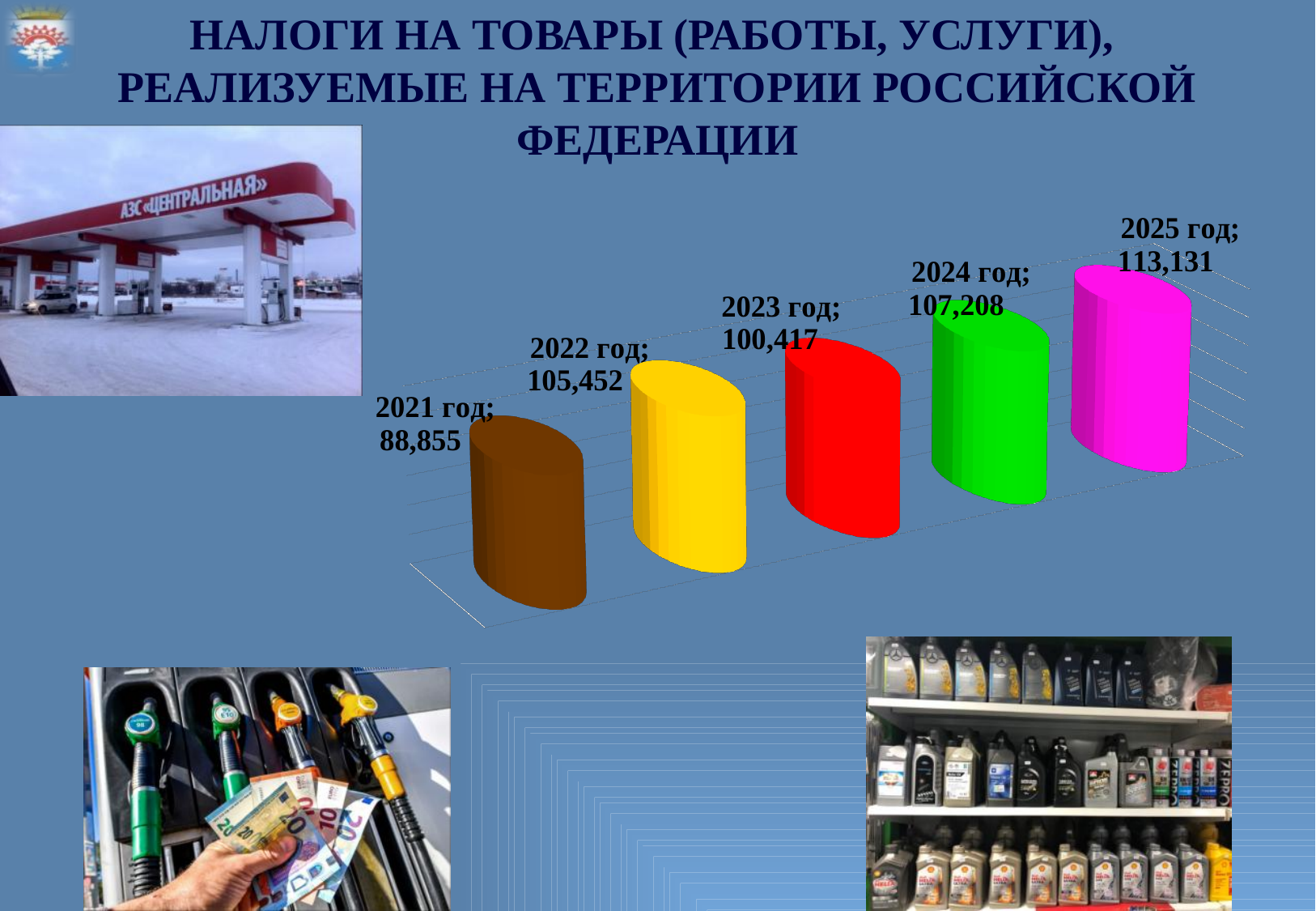
What is the value shown for 2021 год? 88,855 What is the value shown for 2025 год? 113,131 Which is larger, the value for 2024 год or the value for 2025 год? 2025 год What is the difference between the values for 2022 год and 2023 год? 5,035 What is the value shown for 2023 год? 100,417 How many years are plotted on the chart? 5 Which year has the lowest value on the chart? 2021 год Which is larger, the value for 2022 год or the value for 2023 год? 2022 год What is the difference between the values for 2025 год and 2021 год? 24,276 Which year has the highest value on the chart? 2025 год What kind of chart is shown on the slide? bar chart Does the value rise or fall from 2022 год to 2023 год? fall